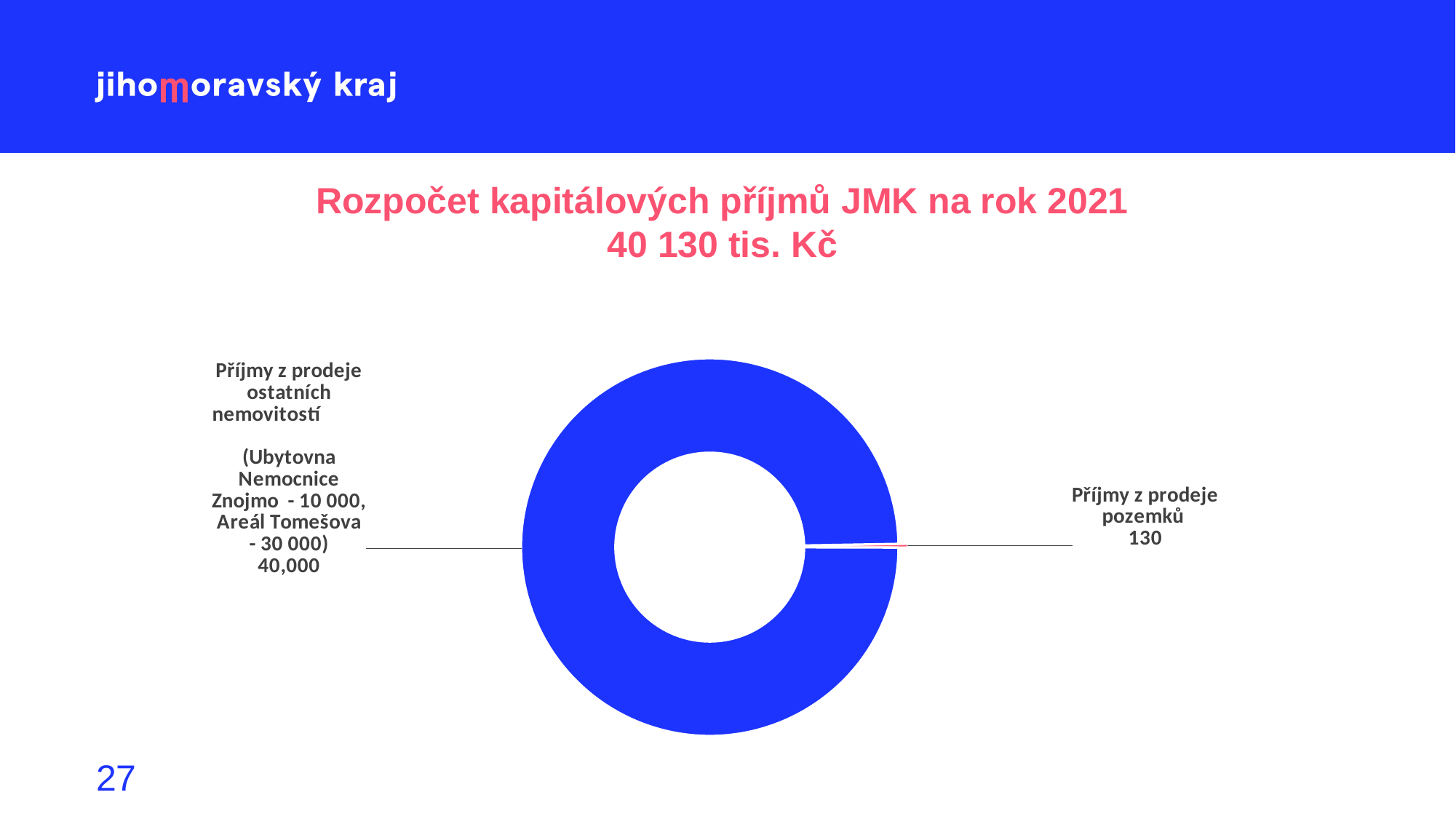
What is the difference between the value for Příjmy z prodeje ostatních nemovitostí and the value for Příjmy z prodeje pozemků? 39,870 What is the total of the two values shown in the chart? 40,130 What colour is the slice for Příjmy z prodeje ostatních nemovitostí? blue What kind of chart is shown on the slide? doughnut chart What is the value for Příjmy z prodeje pozemků? 130 How many categories does the chart show? 2 Which category has the smallest value? Příjmy z prodeje pozemků Which is larger, the value for Příjmy z prodeje pozemků or the value for Příjmy z prodeje ostatních nemovitostí? Příjmy z prodeje ostatních nemovitostí What is the value for Příjmy z prodeje ostatních nemovitostí? 40,000 What is the title of the chart? Rozpočet kapitálových příjmů JMK na rok 2021 40 130 tis. Kč Which category has the largest value? Příjmy z prodeje ostatních nemovitostí